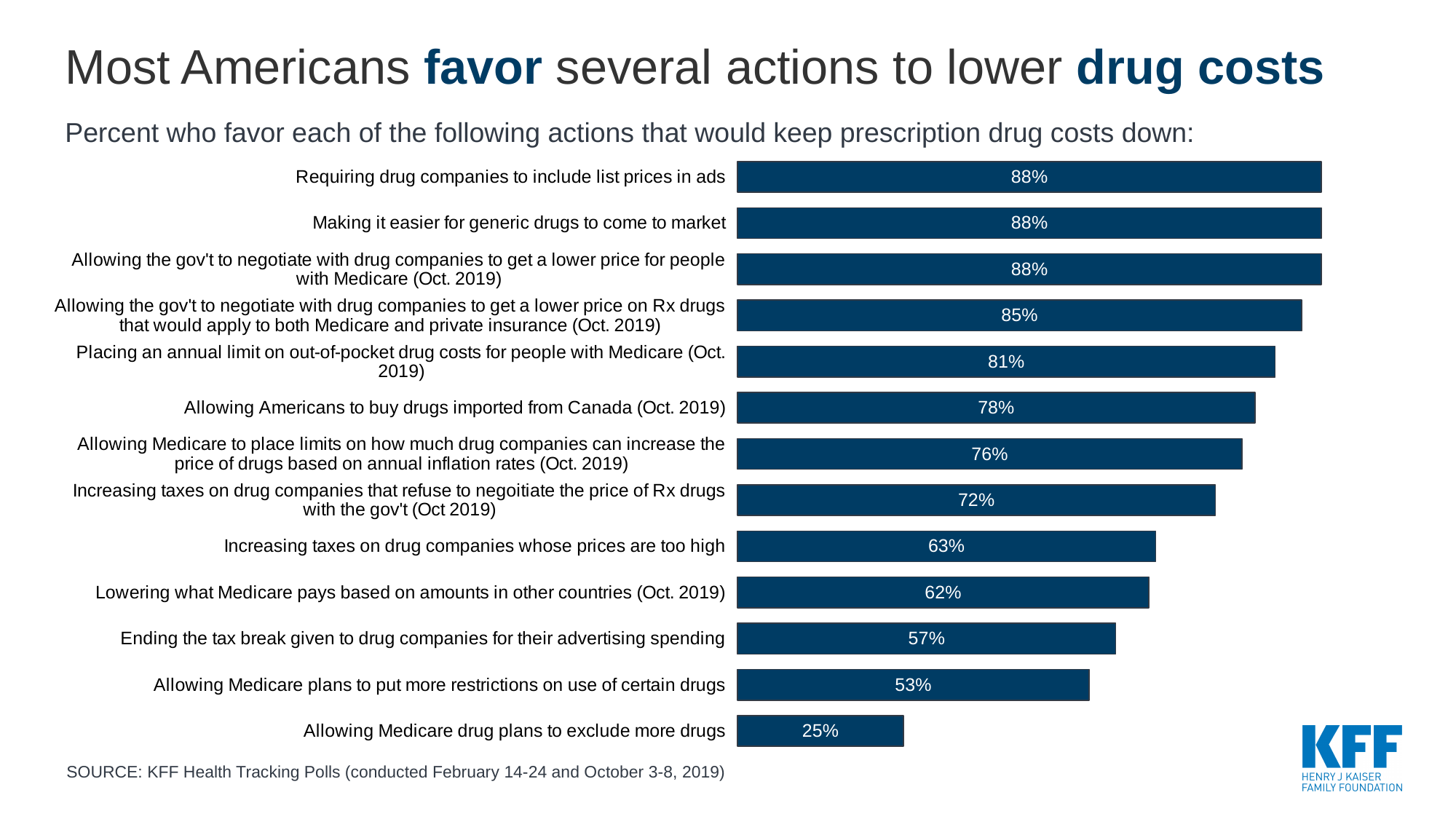
What percent favor allowing Medicare plans to put more restrictions on use of certain drugs? 53% What is the difference between the percent favoring making it easier for generic drugs to come to market and the percent favoring lowering what Medicare pays based on amounts in other countries (Oct. 2019)? 26% How many actions are listed on the chart? 13 How many actions are tied at 88%? 3 What percent favor allowing Americans to buy drugs imported from Canada (Oct. 2019)? 78% What is the difference between the percent favoring increasing taxes on drug companies whose prices are too high and the percent favoring allowing Medicare drug plans to exclude more drugs? 38% Which action has the lowest percent who favor it? Allowing Medicare drug plans to exclude more drugs What percent favor ending the tax break given to drug companies for their advertising spending? 57% What is the highest percent shown on the chart? 88% What kind of chart is shown on the slide? Bar chart Which has a higher percent in favor: increasing taxes on drug companies that refuse to negotiate the price of Rx drugs with the gov't (Oct 2019), or increasing taxes on drug companies whose prices are too high? Increasing taxes on drug companies that refuse to negotiate the price of Rx drugs with the gov't (Oct 2019) What percent favor placing an annual limit on out-of-pocket drug costs for people with Medicare (Oct. 2019)? 81%